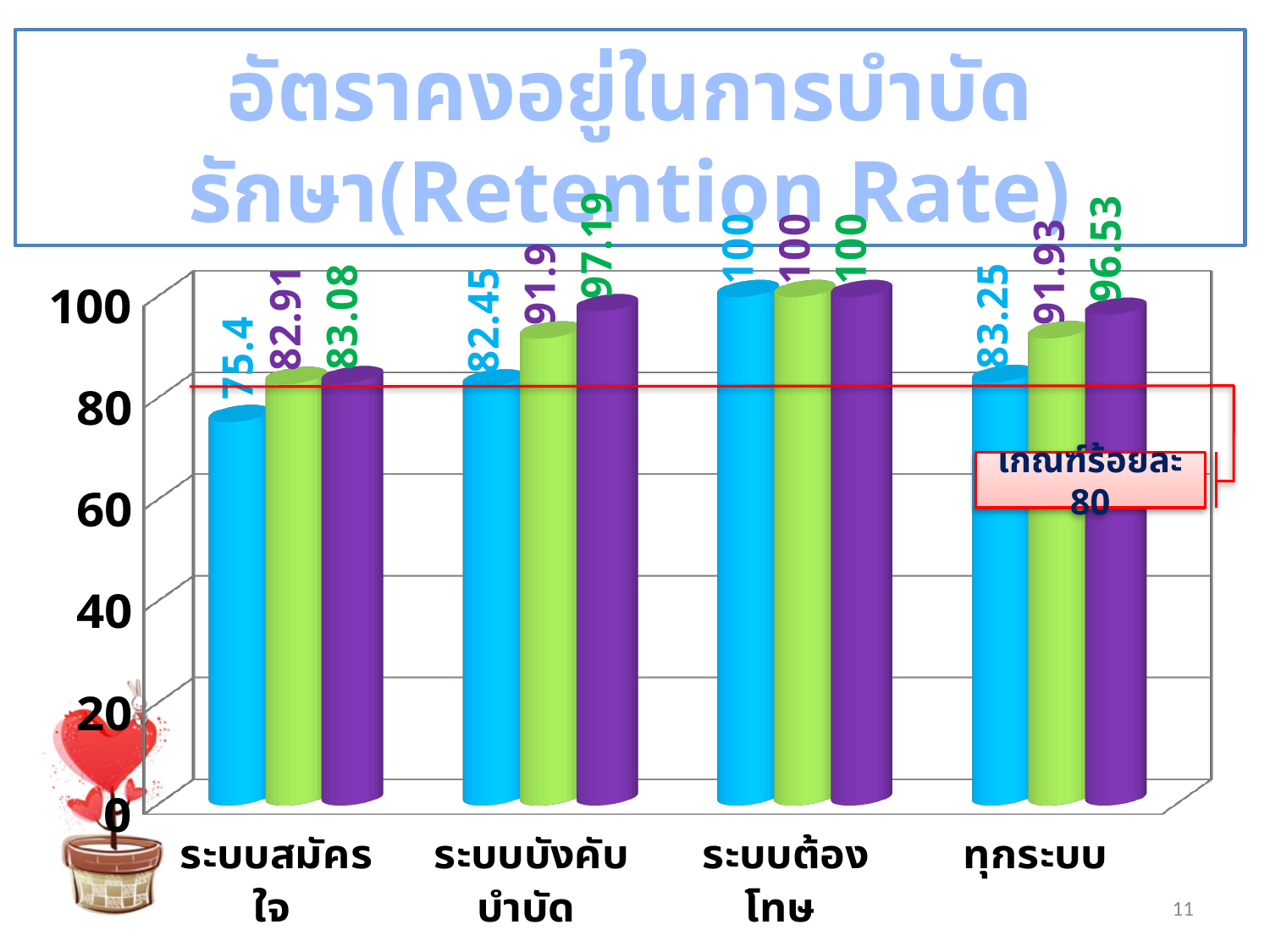
What is the value of the purple bar for ระบบบังคับบำบัด? 97.19 What is the value of the blue bar for ระบบสมัครใจ? 75.4 Which category has the highest purple bar? ระบบต้องโทษ Is the value of the blue bar for ระบบสมัครใจ greater or less than 80? less What is the value of the green bar for ทุกระบบ? 91.93 What is the value of the green bar for ระบบต้องโทษ? 100 What type of chart is shown on the slide? bar chart What threshold value does the red horizontal line on the chart mark, according to its label? 80 What is the difference between the purple bar and the blue bar for ทุกระบบ? 13.28 Which category has the lowest blue bar? ระบบสมัครใจ Which is larger for ระบบบังคับบำบัด, the green bar or the blue bar? the green bar How many categories are shown on the x axis of the chart? 4